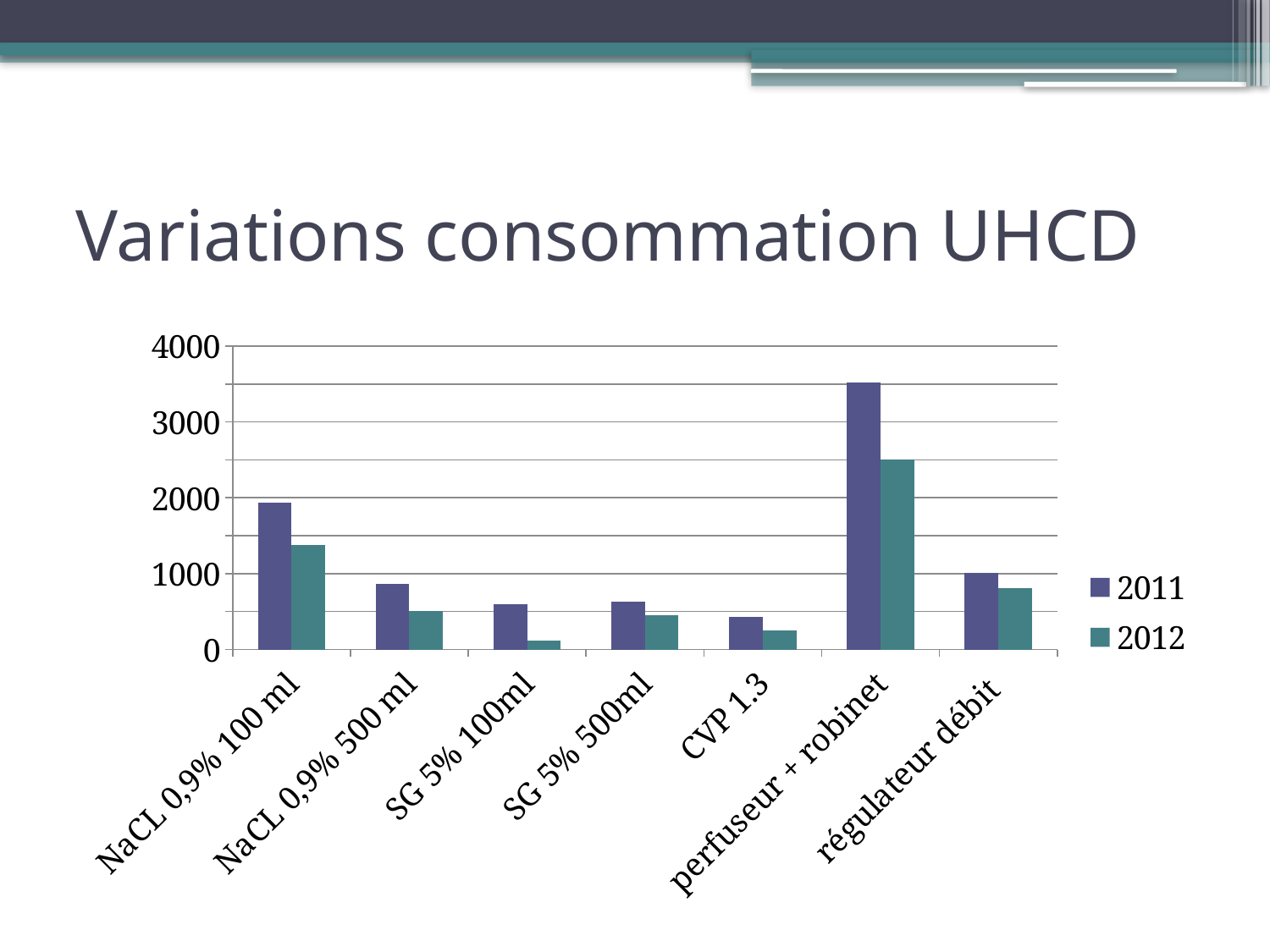
How many categories are shown on the x axis of the chart? 7 Which category has the highest value for 2011? perfuseur + robinet Which category has the lowest value for 2012? SG 5% 100ml How many series does the chart's legend list? 2 Which legend entry is shown in the teal colour? 2012 Is the 2012 value for perfuseur + robinet greater or less than 3000? less What is the title of the slide containing the chart? Variations consommation UHCD For NaCL 0,9% 100 ml, which series has the larger value, 2011 or 2012? 2011 Which category has the highest value for 2012? perfuseur + robinet What kind of chart is shown on the slide? Bar chart Is the 2011 value for perfuseur + robinet greater or less than 3000? greater Is the 2012 value for NaCL 0,9% 100 ml greater or less than 1000? greater